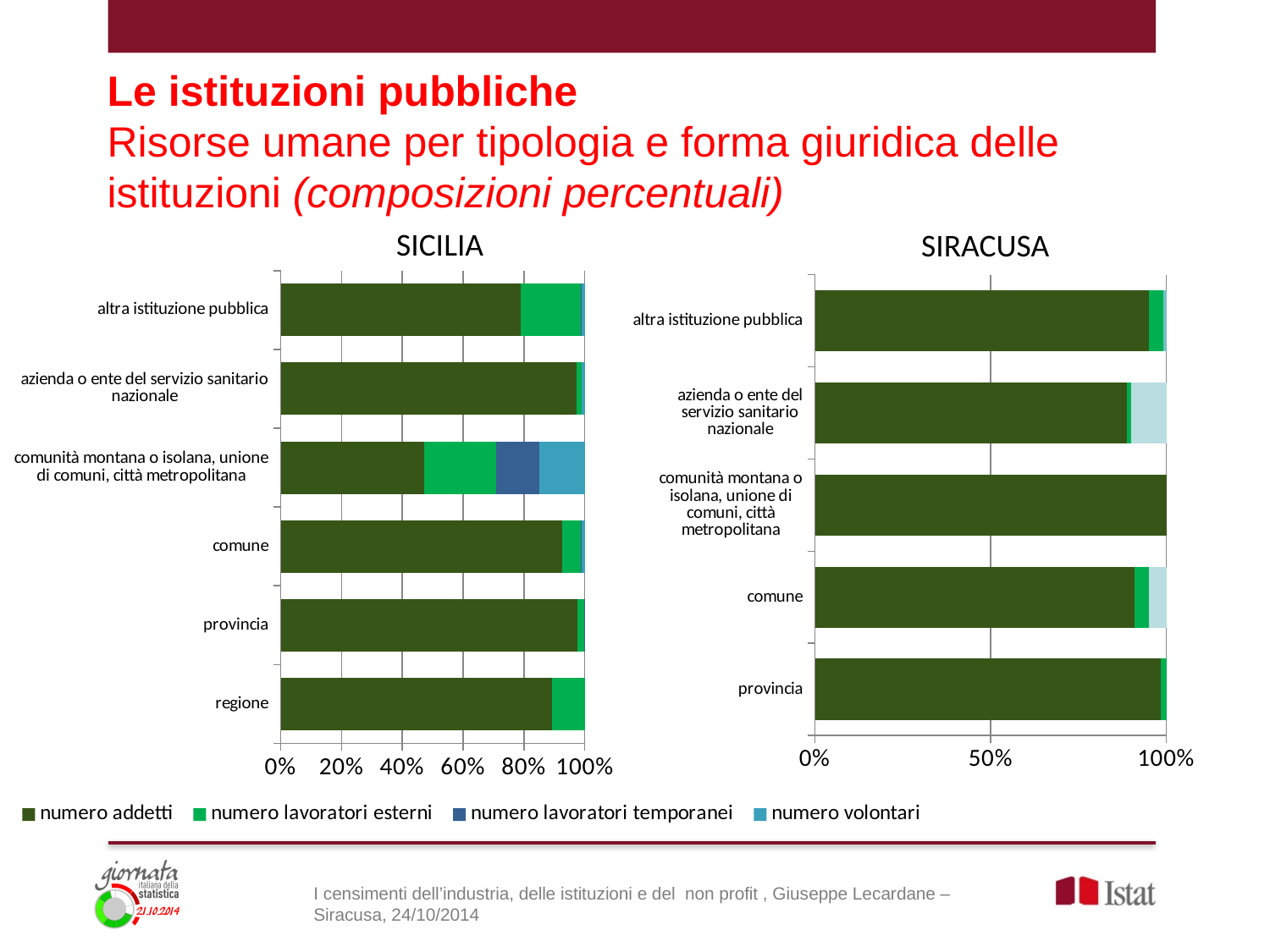
What is the title of the chart on the right? SIRACUSA In the SICILIA chart, which has the larger numero addetti share: 'regione' or 'comunità montana o isolana, unione di comuni, città metropolitana'? regione In the SIRACUSA chart, which category has the largest numero addetti share? comunità montana o isolana, unione di comuni, città metropolitana How many categories are shown in the SICILIA chart? 6 What kind of chart is the SICILIA chart? stacked bar chart How many categories are shown in the SIRACUSA chart? 5 In the SICILIA chart, is the numero addetti share for 'regione' greater or less than 80%? greater In the SIRACUSA chart, is the numero addetti share for 'azienda o ente del servizio sanitario nazionale' greater or less than 50%? greater In the SICILIA chart, which has the larger numero lavoratori esterni share: 'altra istituzione pubblica' or 'comune'? altra istituzione pubblica In the SICILIA chart, which category has the smallest numero addetti share? comunità montana o isolana, unione di comuni, città metropolitana How many series does the legend list? 4 In the SICILIA chart, is the numero addetti share for 'comunità montana o isolana, unione di comuni, città metropolitana' greater or less than 60%? less